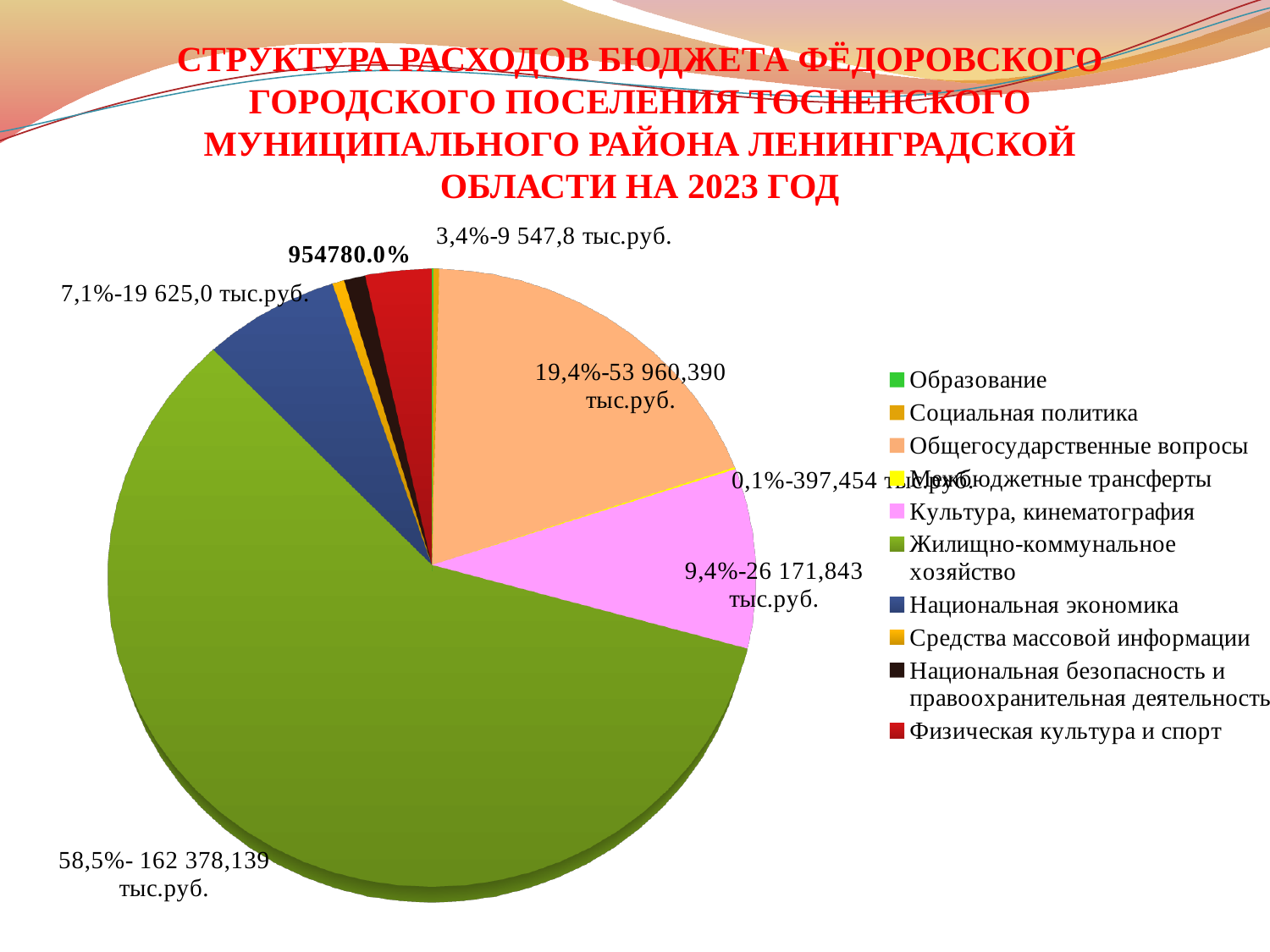
What amount in тыс.руб. is shown for Общегосударственные вопросы? 53 960,390 тыс.руб. What share of the pie does Жилищно-коммунальное хозяйство account for? 58,5% By how many percentage points does the share of Жилищно-коммунальное хозяйство exceed that of Общегосударственные вопросы? 39,1% How many categories does the legend of the pie chart list? 10 What share of the pie does Национальная экономика account for? 7,1% What share of the pie does Общегосударственные вопросы account for? 19,4% For which year does the chart title say the budget expenditure structure is shown? 2023 Which category has the largest slice of the pie chart? Жилищно-коммунальное хозяйство What kind of chart is shown on the slide? pie chart What amount in тыс.руб. is shown for Жилищно-коммунальное хозяйство? 162 378,139 тыс.руб. Which slice is larger: Культура, кинематография or Национальная экономика? Культура, кинематография